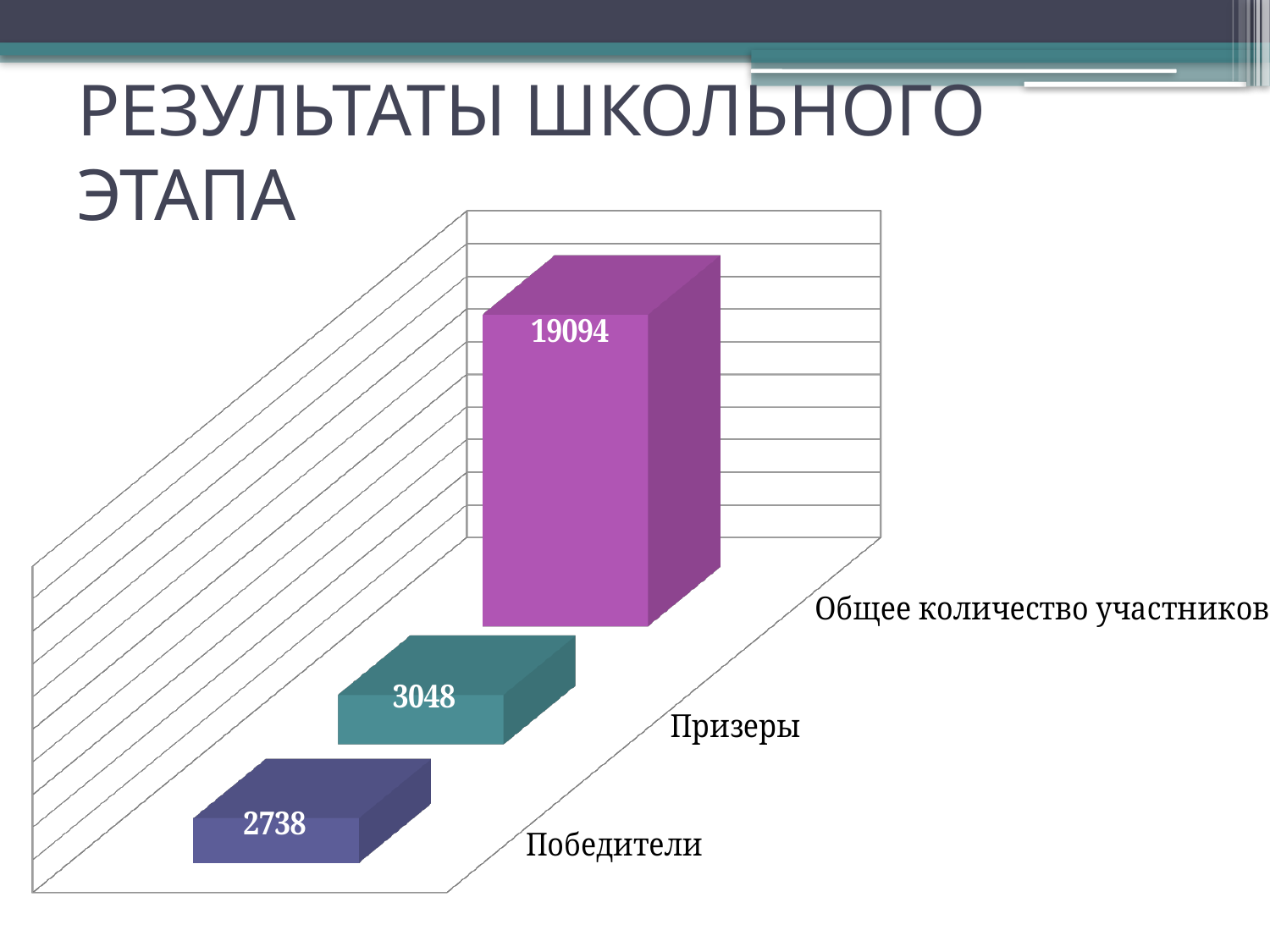
What kind of chart is shown on the slide? Bar chart Which category has the highest value? Общее количество участников What is the value for Победители? 2738 What is the title of the slide containing the chart? РЕЗУЛЬТАТЫ ШКОЛЬНОГО ЭТАПА Which is larger, the value for Призеры or the value for Победители? Призеры What colour is the bar for Общее количество участников? Purple What is the difference between the values for Призеры and Победители? 310 What is the value for Общее количество участников? 19094 What is the difference between the values for Общее количество участников and Призеры? 16046 Which category has the lowest value? Победители What is the value for Призеры? 3048 How many categories are shown in the chart? 3